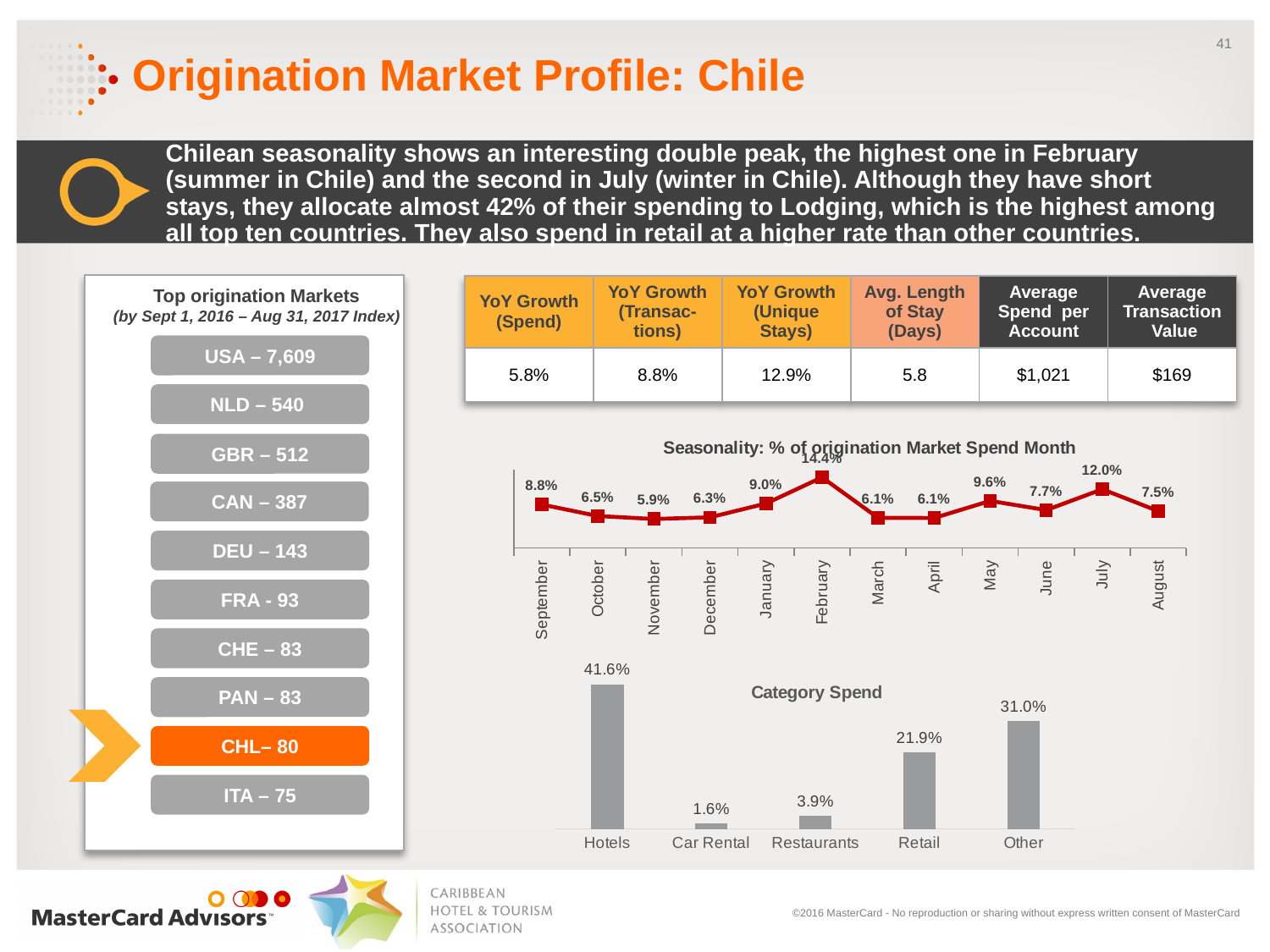
In the Seasonality chart, which month has the highest value? February In the Seasonality chart, is the value for September larger or smaller than the value for May? Smaller In the Category Spend chart, what is the difference between Other and Retail? 9.1% In the Seasonality chart, what is the value for February? 14.4% In the Seasonality chart, how many months are plotted? 12 In the Category Spend chart, which category has the lowest value? Car Rental In the Category Spend chart, how many categories are shown? 5 What kind of chart is the Category Spend chart? Bar chart What kind of chart is the Seasonality chart? Line chart In the Seasonality chart, which month has the lowest value? November In the Category Spend chart, what is the value for Hotels? 41.6% In the Seasonality chart, what is the difference between the February and July values? 2.4%